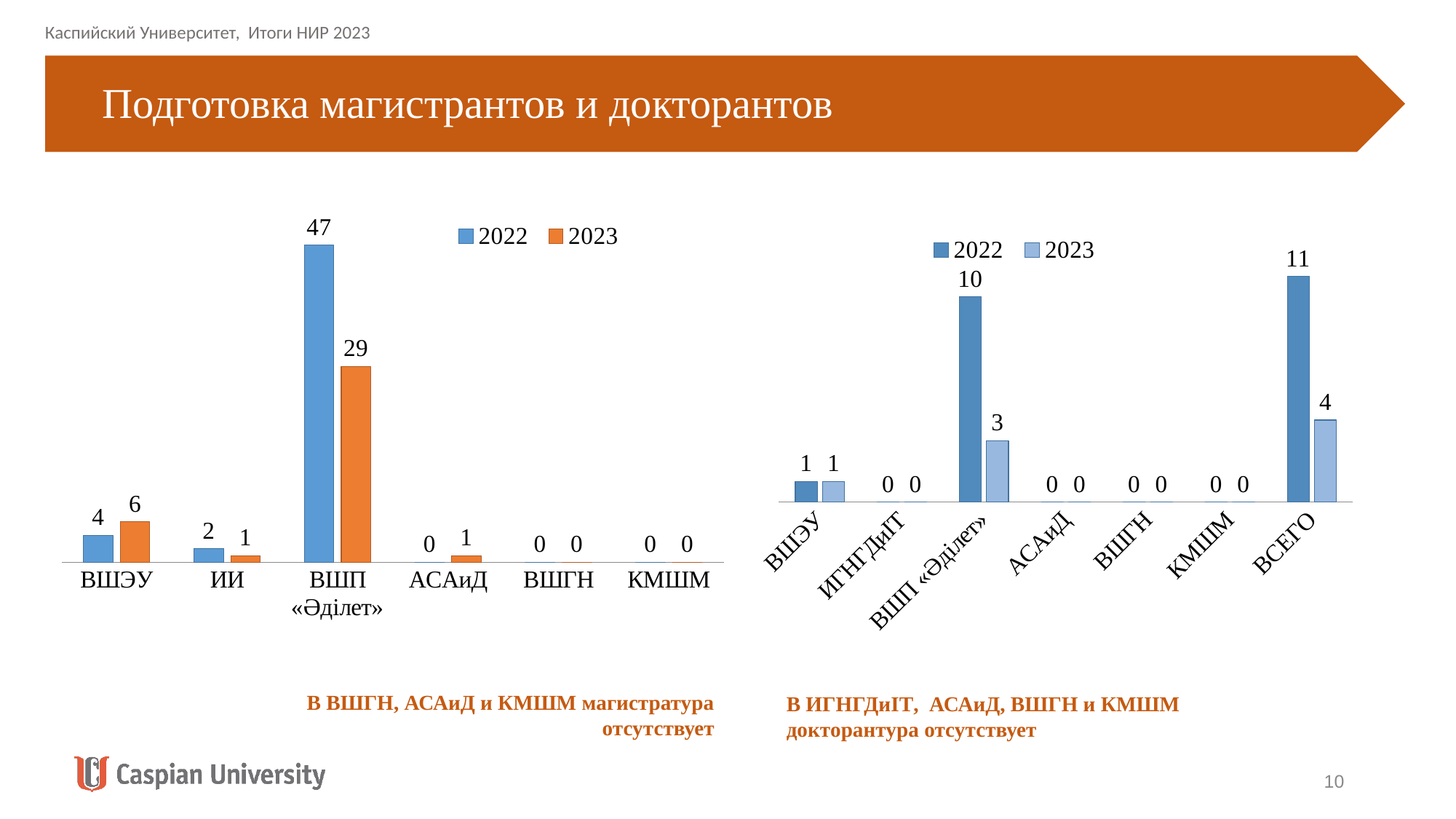
How many categories are shown on the x axis of the right chart? 7 In the right chart, what is the 2022 value for ВСЕГО? 11 How many categories are shown on the x axis of the left chart? 6 In the left chart, what is the 2023 value for ВШЭУ? 6 In the right chart, what is the 2023 value for ВШП «Әділет»? 3 In the left chart, which is larger for ИИ: the 2022 value or the 2023 value? 2022 What type of chart is the left chart? Bar chart In the right chart, what is the difference between the 2022 and 2023 values for ВСЕГО? 7 In the left chart, what is the difference between the 2022 and 2023 values for ВШП «Әділет»? 18 In the left chart, which category has the highest 2023 value? ВШП «Әділет» In the left chart, what is the 2022 value for ВШП «Әділет»? 47 How many series does the legend of the right chart list? 2